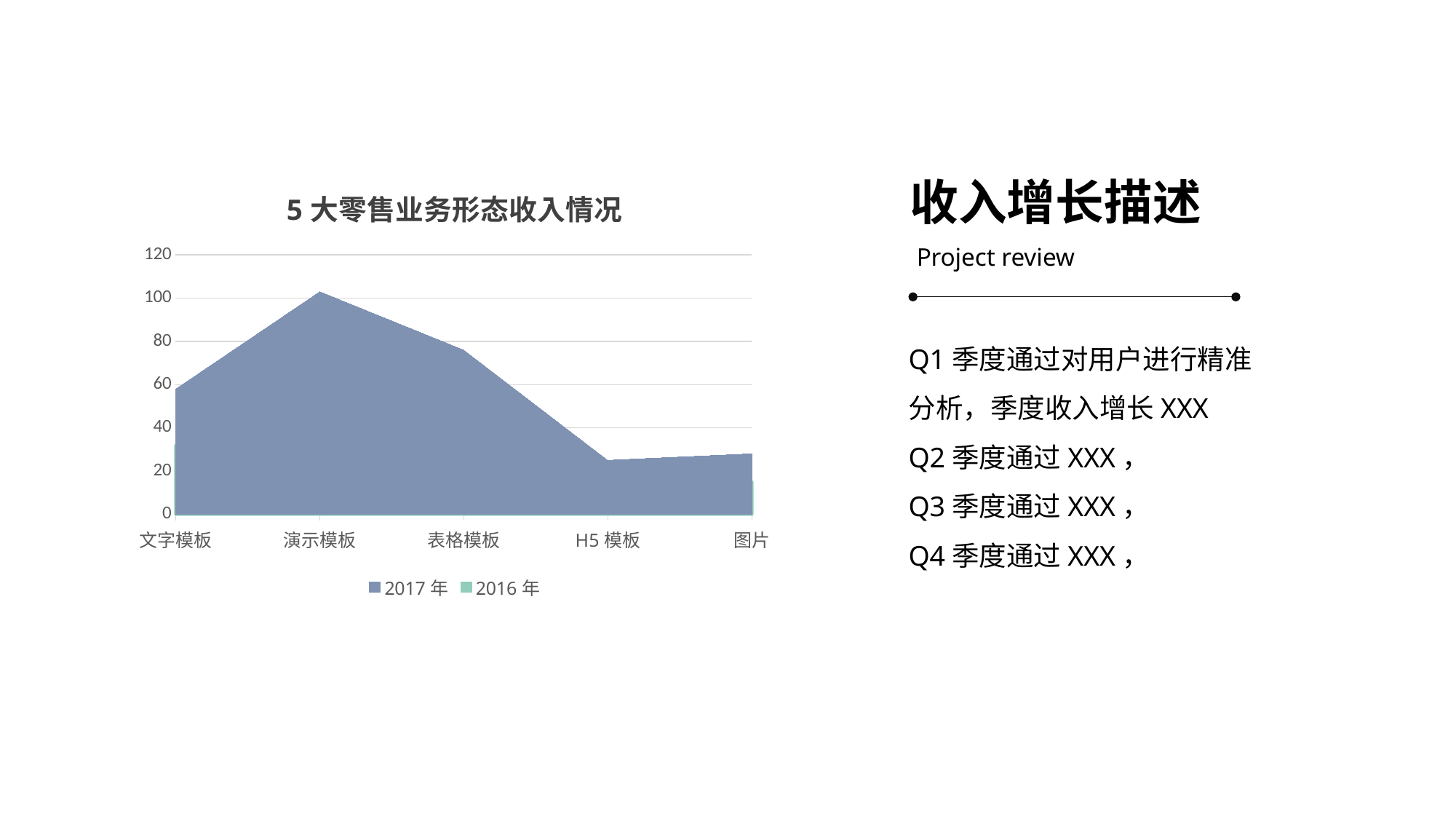
What is the title of the chart? 5 大零售业务形态收入情况 Is the 2017 年 value for 表格模板 greater or less than 60? greater Is the 2017 年 value for 文字模板 greater or less than 40? greater Is the 2017 年 value for 演示模板 greater or less than 80? greater Which series are listed in the chart's legend? 2017 年 and 2016 年 What kind of chart is shown on the slide? Area chart Which category has the highest value for the 2017 年 series? 演示模板 How many series does the chart's legend list? 2 Does the 2017 年 series rise or fall from 演示模板 to H5 模板? fall Which has the larger 2017 年 value, 演示模板 or 表格模板? 演示模板 How many categories are shown on the x axis of the chart? 5